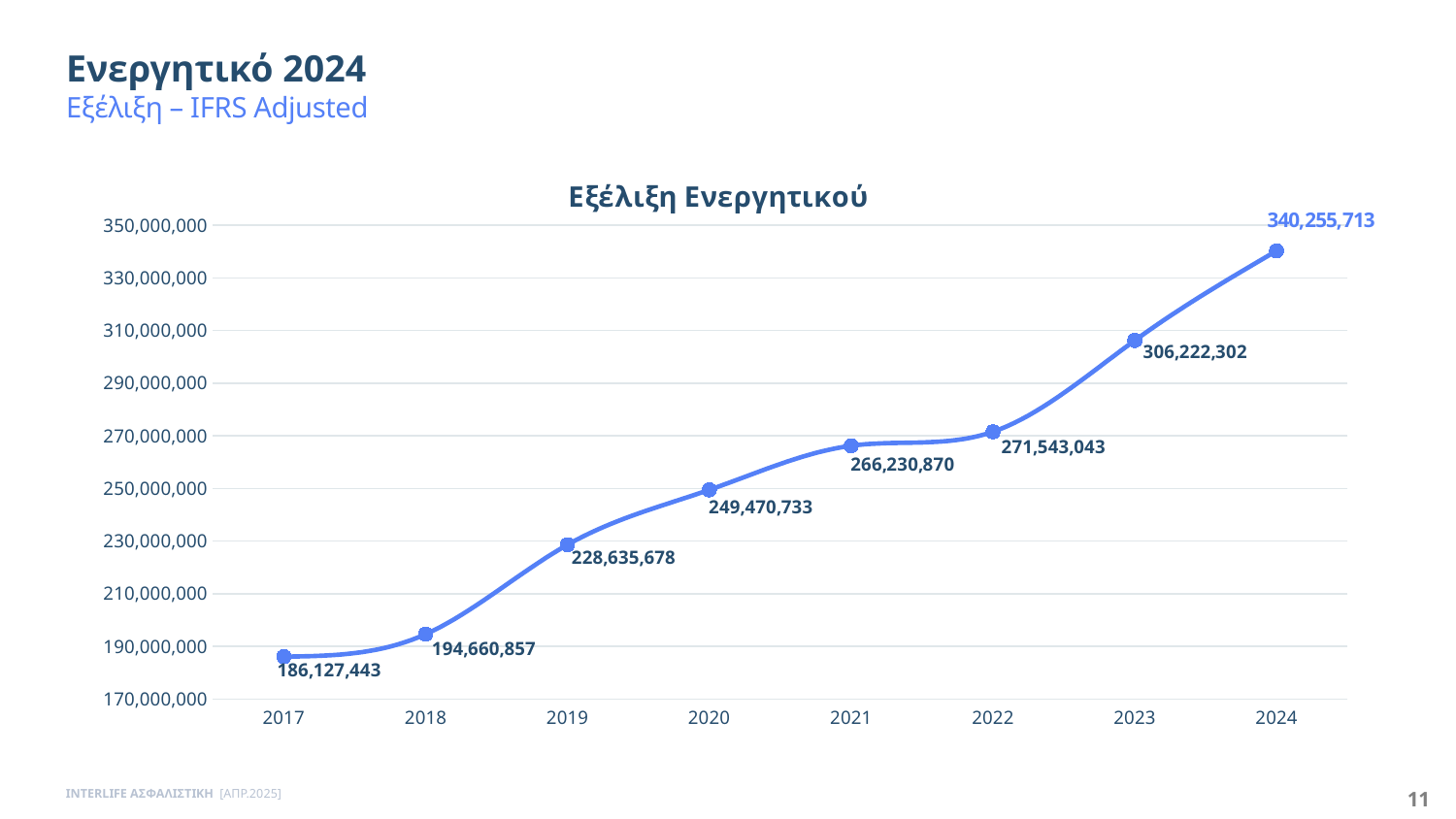
What type of chart is shown on the slide? line chart Which year has the highest value? 2024 Which is larger, the value for 2021 or the value for 2019? 2021 What is the title of the chart? Εξέλιξη Ενεργητικού What is the value for 2020? 249,470,733 What is the value for 2017? 186,127,443 What is the difference between the values for 2023 and 2022? 34,679,259 Do the values rise or fall from 2017 to 2024? rise What is the value for 2023? 306,222,302 Which year has the lowest value? 2017 How many years are plotted on the chart? 8 What is the difference between the values for 2024 and 2017? 154,128,270